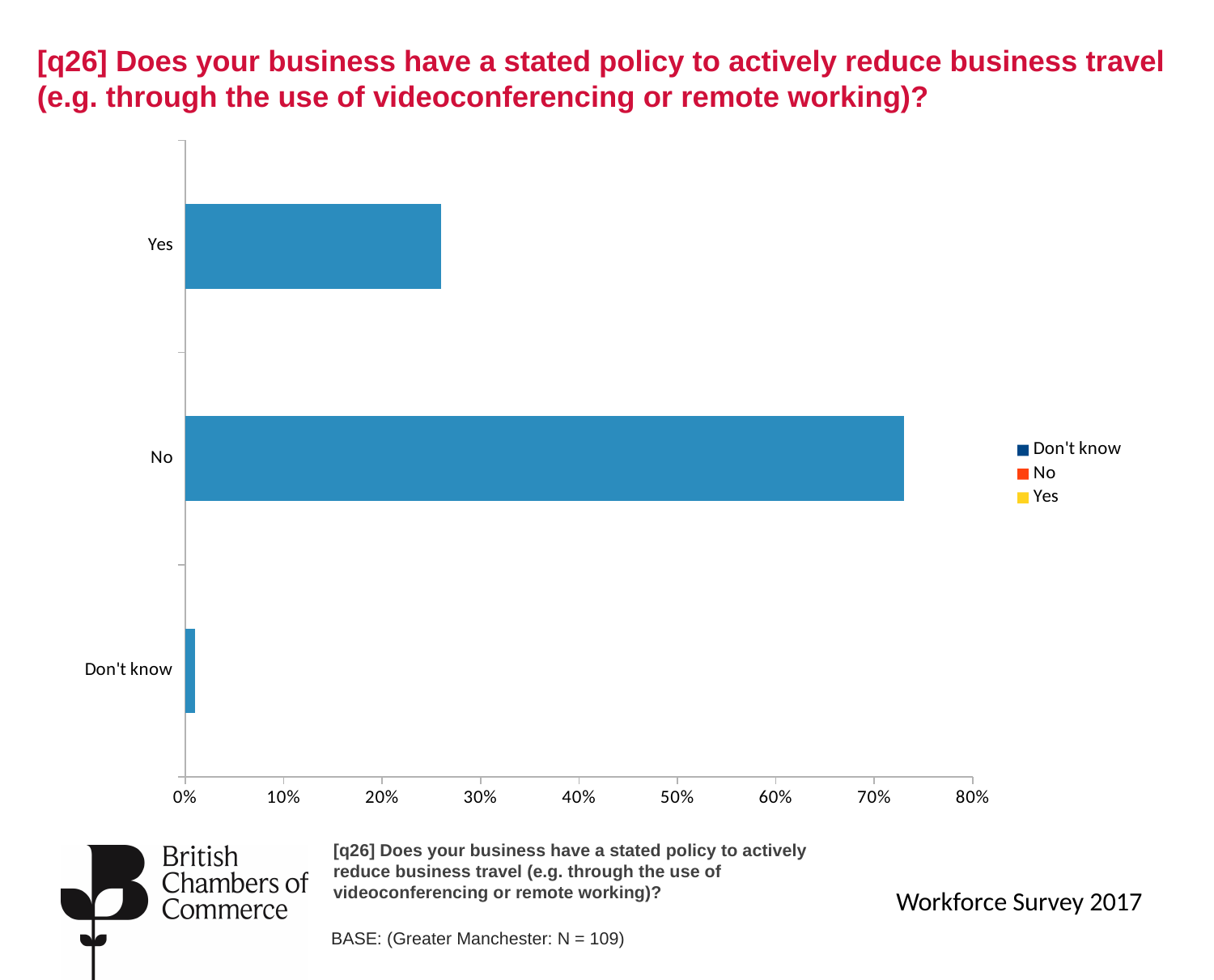
Which category has the highest value? No What kind of chart is shown on the slide? bar chart How many categories are plotted on the chart? 3 Is the value for Don't know greater or less than 10%? less Is the value for No greater or less than 70%? greater Which is larger, the value for Yes or the value for Don't know? Yes Which is larger, the value for Yes or the value for No? No What is the highest value shown on the horizontal axis of the chart? 80% Is the value for Yes greater or less than 20%? greater How many entries does the chart legend list? 3 Which category has the lowest value? Don't know